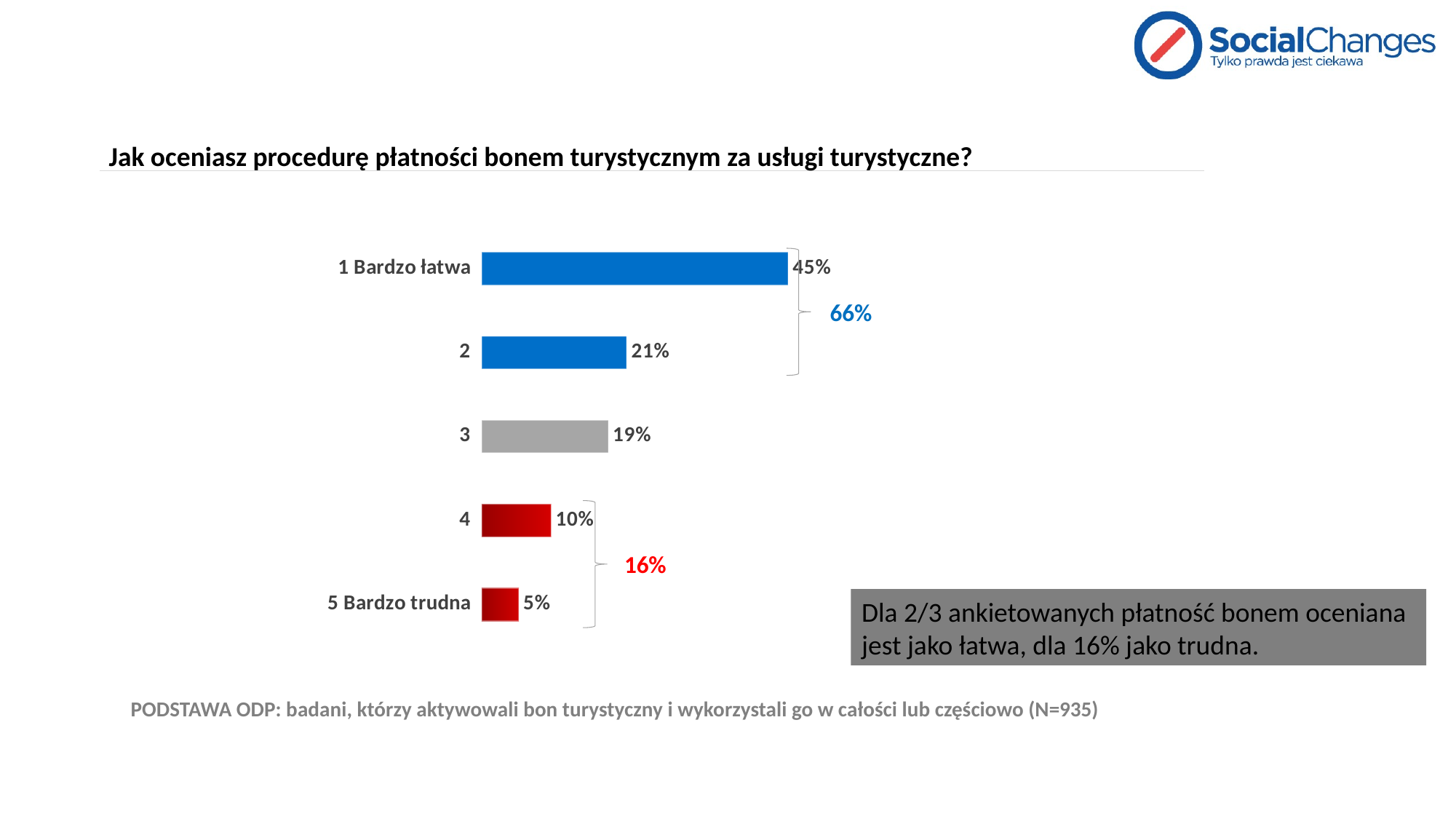
Which category has the lowest value? 5 Bardzo trudna Which category has the highest value? 1 Bardzo łatwa What combined percentage is shown by the bracket grouping categories "1 Bardzo łatwa" and "2"? 66% What is the difference between the values for category "4" and "5 Bardzo trudna"? 5% What is the value for "1 Bardzo łatwa"? 45% Which is larger, the value for category "2" or category "3"? 2 What combined percentage is shown by the bracket grouping categories "4" and "5 Bardzo trudna"? 16% What is the difference between the values for "1 Bardzo łatwa" and "2"? 24% What kind of chart is shown on the slide? Bar chart How many categories are shown in the chart? 5 What is the value for "5 Bardzo trudna"? 5% What is the value for category "3"? 19%